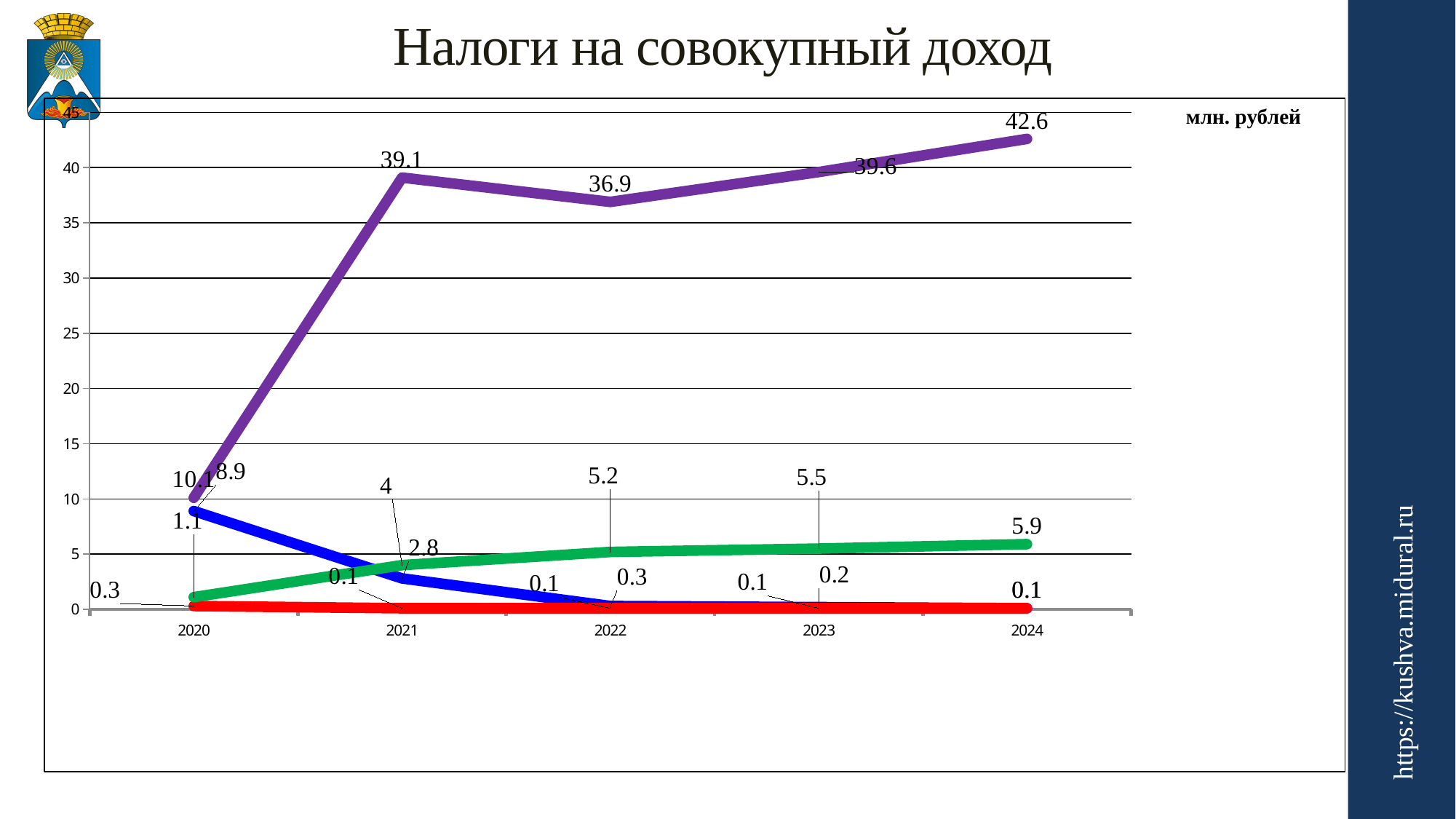
What kind of chart is shown on the slide? line chart In which year does the purple line reach its highest value? 2024 How many years are shown on the x axis? 5 Which is larger in 2021, the green line's value or the blue line's value? the green line (4) What is the difference between the purple line's values in 2024 and 2020? 32.5 What is the value of the green line in 2022? 5.2 Is the purple line's value in 2022 greater or less than 35? greater What is the value of the purple line in 2024? 42.6 What is the value of the blue line in 2020? 8.9 In which year does the purple line have its lowest value? 2020 What is the value of the purple line in 2021? 39.1 Does the green line rise or fall from 2020 to 2024? rises